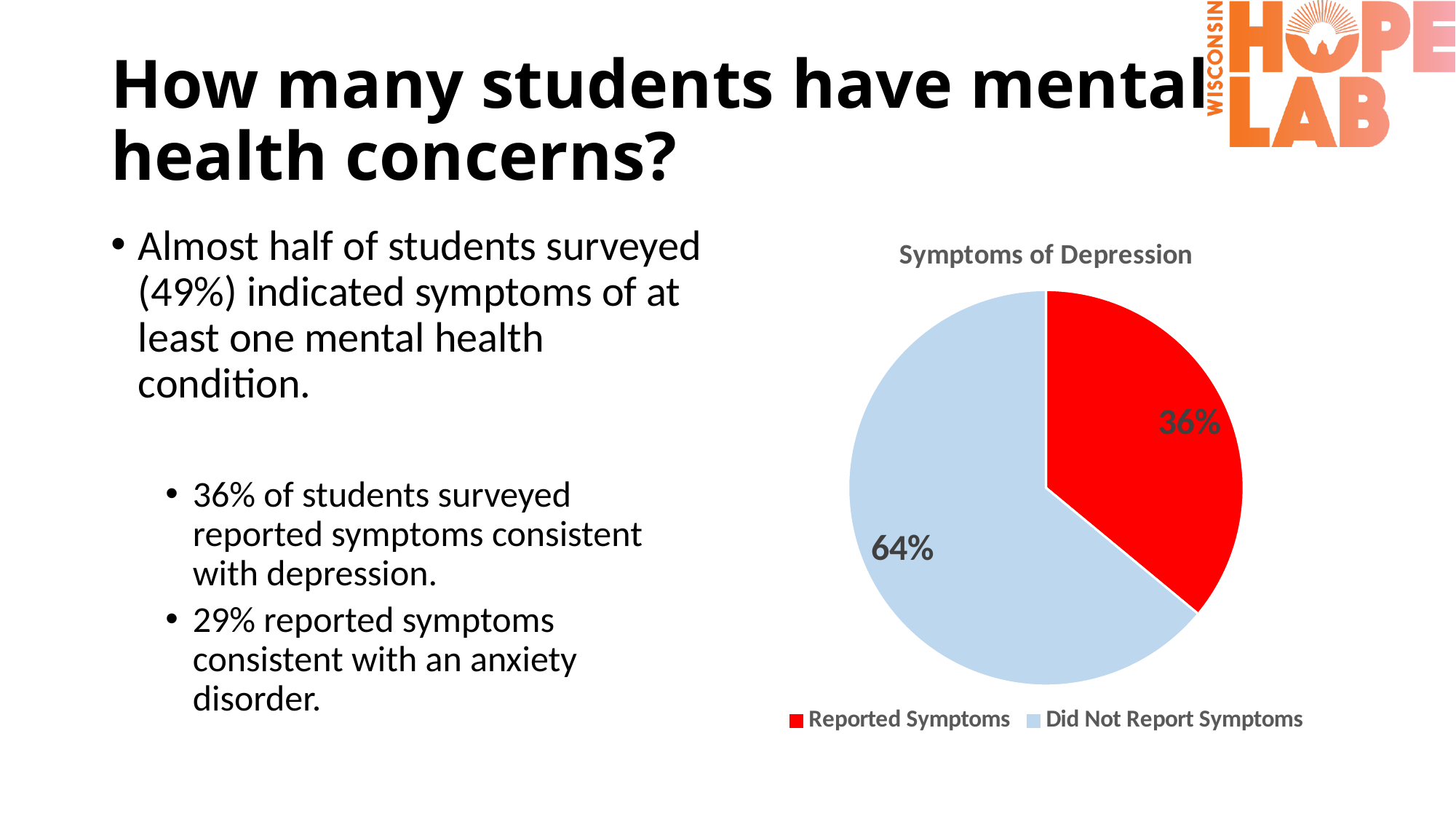
What is the title of the chart? Symptoms of Depression What is the difference in percentage points between the Did Not Report Symptoms slice and the Reported Symptoms slice? 28 Which is larger: the Reported Symptoms slice or the Did Not Report Symptoms slice? Did Not Report Symptoms How many entries does the chart legend list? 2 What share of the pie is labelled Did Not Report Symptoms? 64% What share of the pie is labelled Reported Symptoms? 36% How many slices does the pie chart have? 2 What kind of chart is shown on the slide? Pie chart What colour is the Reported Symptoms slice? Red Which slice of the pie is the largest? Did Not Report Symptoms Which slice of the pie is the smallest? Reported Symptoms